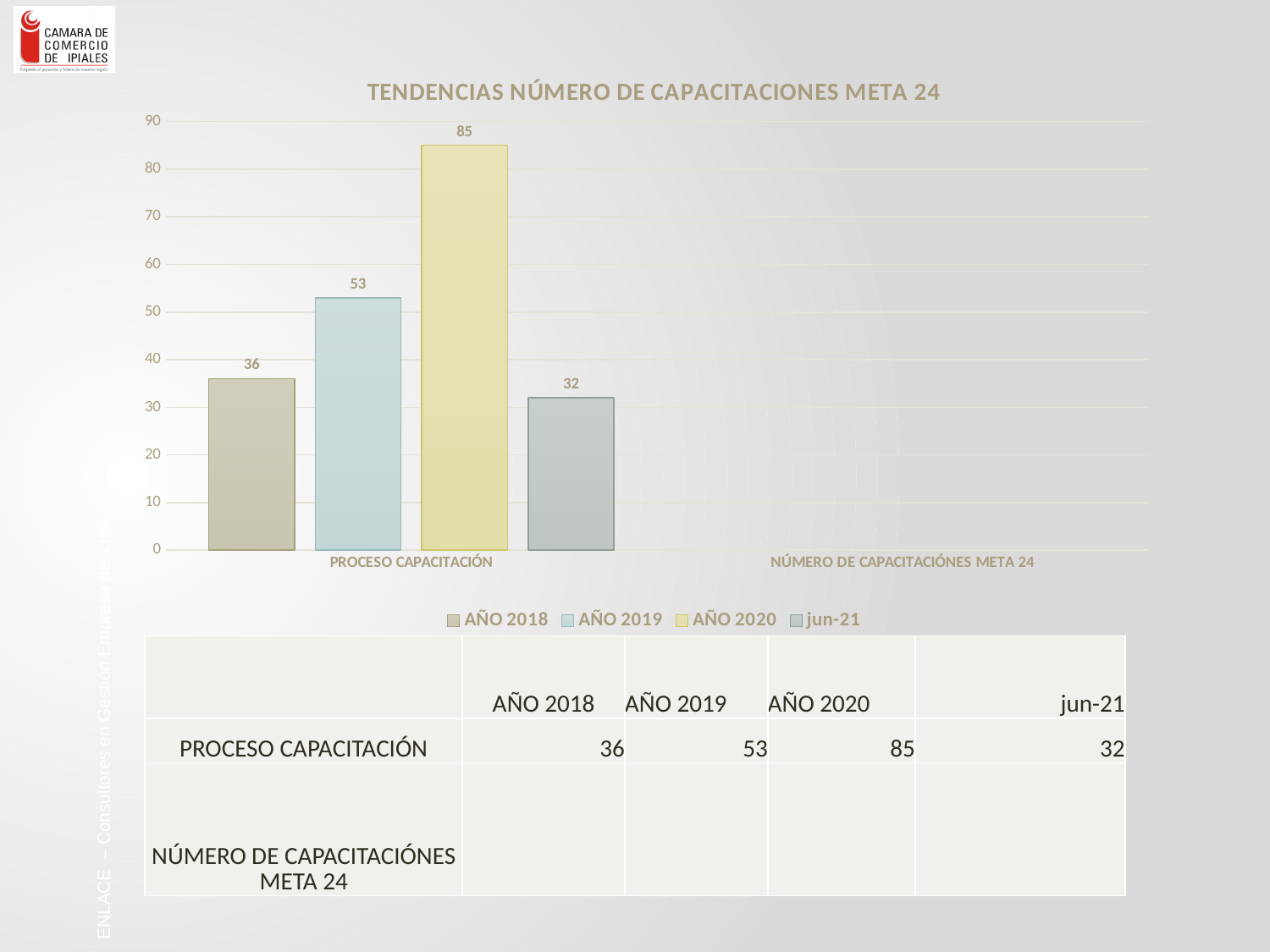
What kind of chart is shown on the slide? Bar chart Which is larger for PROCESO CAPACITACIÓN: the AÑO 2018 value or the jun-21 value? AÑO 2018 What is the value for AÑO 2020 in the PROCESO CAPACITACIÓN category? 85 How many series does the legend list? 4 Which series has the lowest value for PROCESO CAPACITACIÓN? jun-21 What is the title of the chart? TENDENCIAS NÚMERO DE CAPACITACIONES META 24 What is the value for AÑO 2019 in the PROCESO CAPACITACIÓN category? 53 What is the value for AÑO 2018 in the PROCESO CAPACITACIÓN category? 36 What is the value for jun-21 in the PROCESO CAPACITACIÓN category? 32 Which series has the highest value for PROCESO CAPACITACIÓN? AÑO 2020 What is the difference between the AÑO 2020 and AÑO 2019 values for PROCESO CAPACITACIÓN? 32 What is the difference between the AÑO 2019 and AÑO 2018 values for PROCESO CAPACITACIÓN? 17